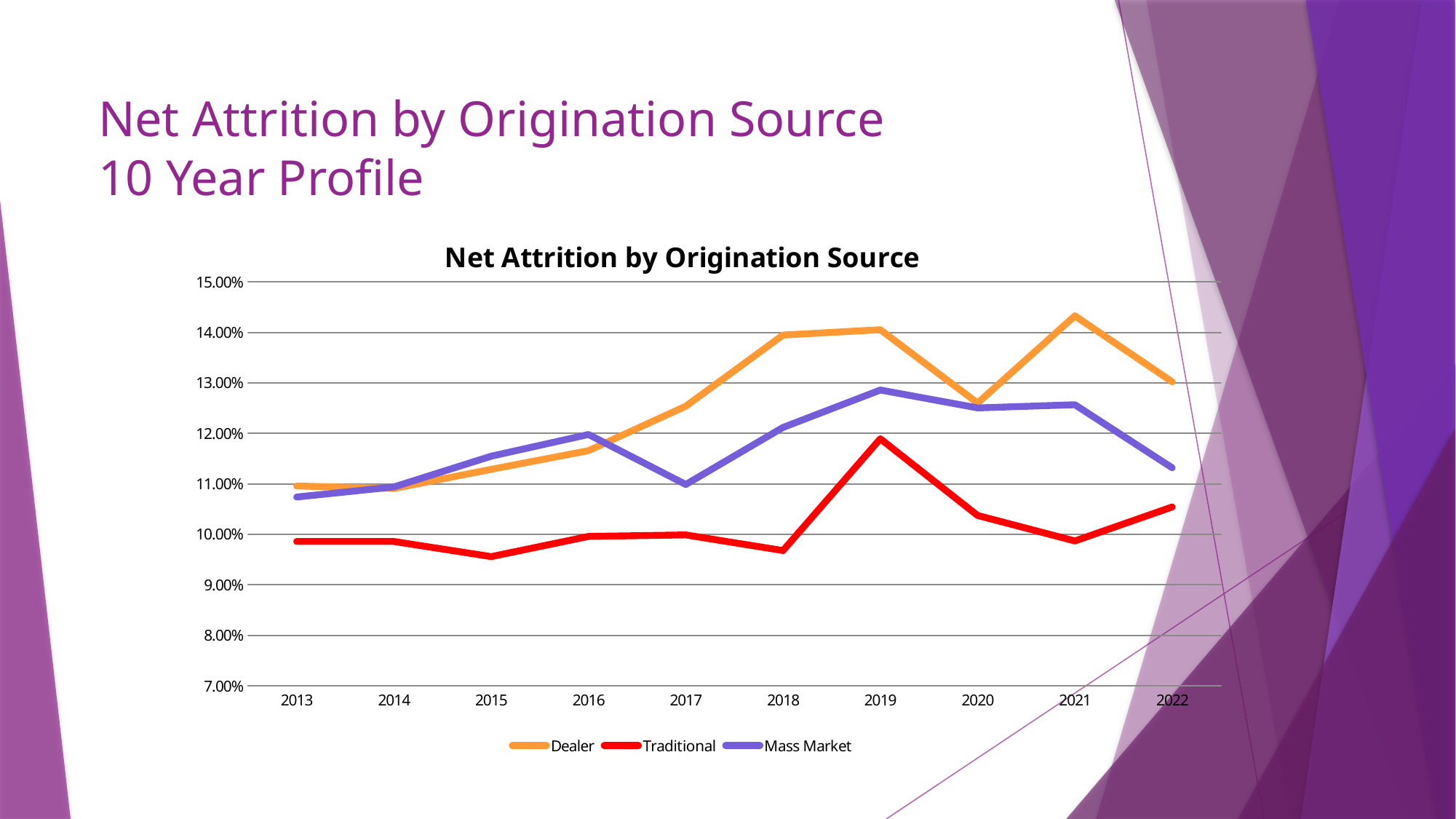
How many series does the legend list? 3 Is the Dealer value for 2021 greater or less than 14.00%? greater What kind of chart is shown on the slide? line chart In 2017, which is larger, the Dealer value or the Mass Market value? Dealer In which year does the Dealer series reach its highest value? 2021 What is the title of the chart? Net Attrition by Origination Source Is the Mass Market value for 2019 greater or less than 13.00%? less How many years are plotted along the x axis? 10 In which year does the Traditional series reach its lowest value? 2015 Which series is drawn in red? Traditional In which year does the Traditional series reach its highest value? 2019 Is the Traditional value for 2015 greater or less than 10.00%? less